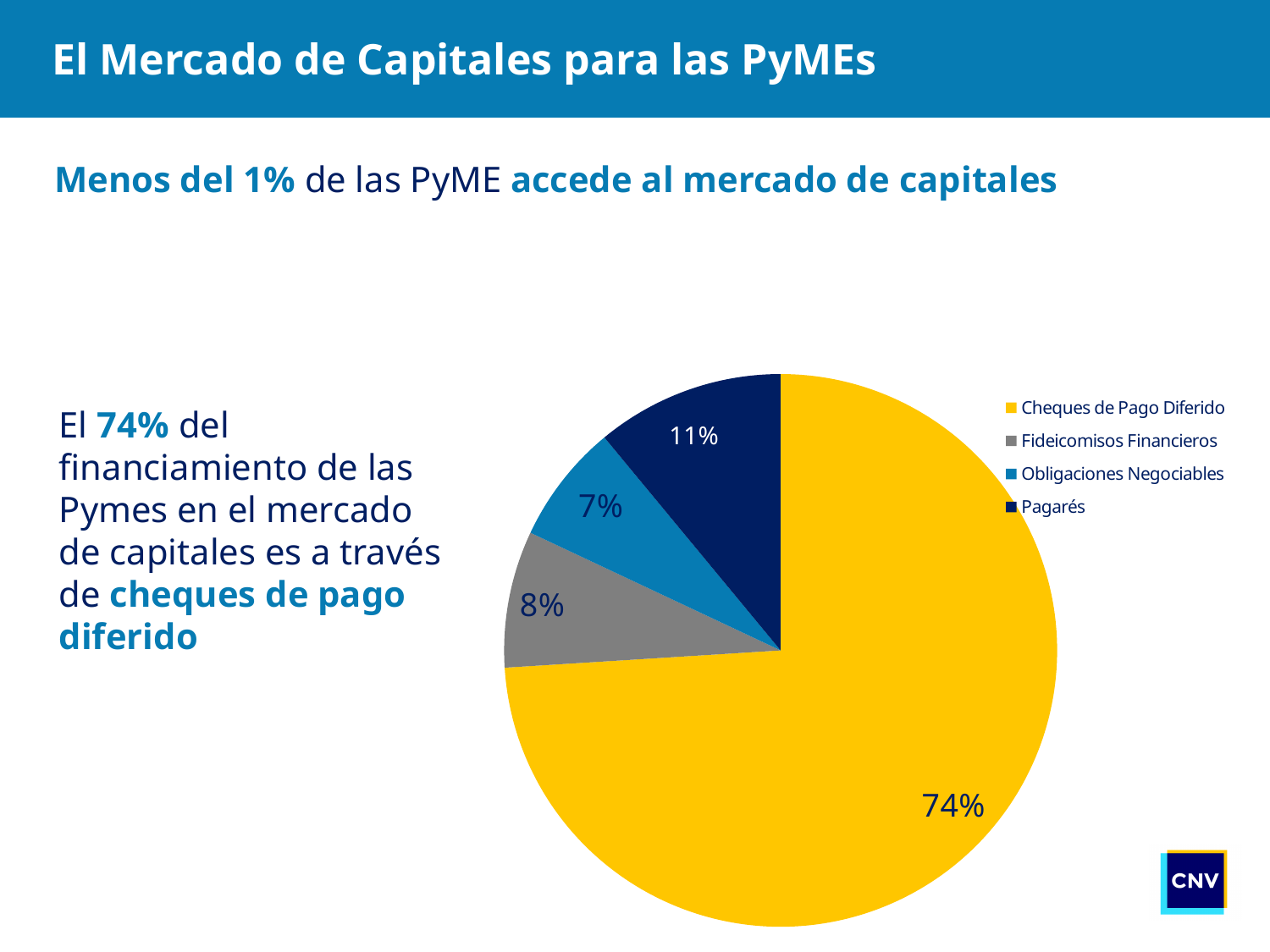
What share of the pie does Cheques de Pago Diferido represent? 74% What is the value shown for Fideicomisos Financieros? 8% What is the value shown for Pagarés? 11% Which is larger, the share for Pagarés or the share for Fideicomisos Financieros? Pagarés What is the difference between the Cheques de Pago Diferido share and the Pagarés share? 63% Which category has the smallest slice of the pie? Obligaciones Negociables Which legend entry is shown in grey? Fideicomisos Financieros How many categories does the pie chart have? 4 What colour is the slice for Cheques de Pago Diferido? yellow What kind of chart is shown on the slide? pie chart Which category has the largest slice of the pie? Cheques de Pago Diferido What is the value shown for Obligaciones Negociables? 7%